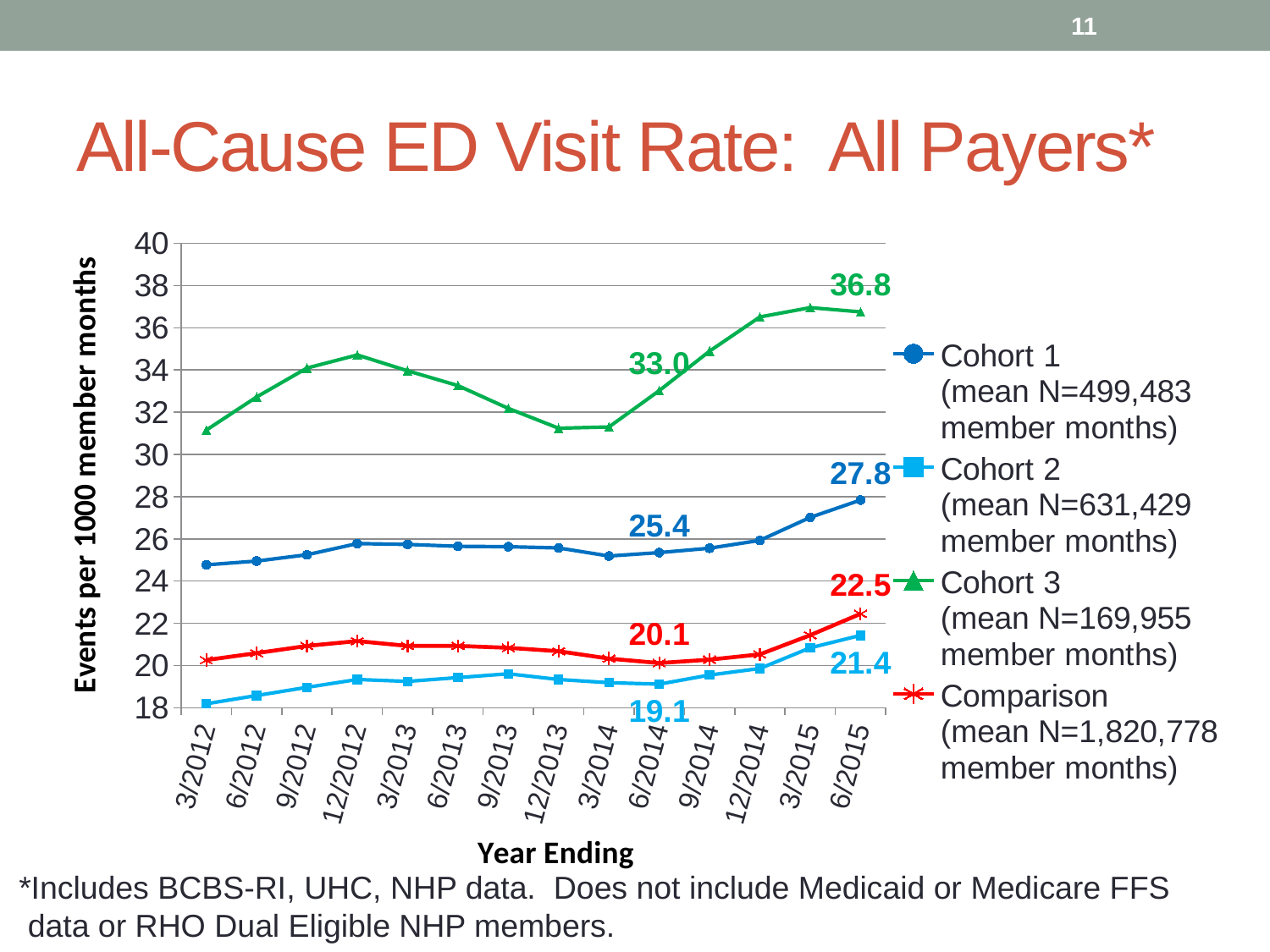
What is the value for Cohort 1 at year ending 6/2014? 25.4 At year ending 6/2015, which is larger: the Comparison value or the Cohort 2 value? Comparison Which series has the highest value at year ending 6/2015? Cohort 3 Is the value for Cohort 3 at year ending 3/2012 greater or less than 32? less What is the value for Cohort 2 at year ending 6/2014? 19.1 What is the value for Cohort 3 at year ending 6/2015? 36.8 How many series does the legend list? 4 How many year-ending points are plotted along the x axis? 14 What is the value for the Comparison series at year ending 6/2015? 22.5 What kind of chart is shown on the slide? Line chart By how much did the Cohort 1 value increase from year ending 6/2014 to year ending 6/2015? 2.4 What is the difference between the Cohort 3 and Cohort 1 values at year ending 6/2015? 9.0